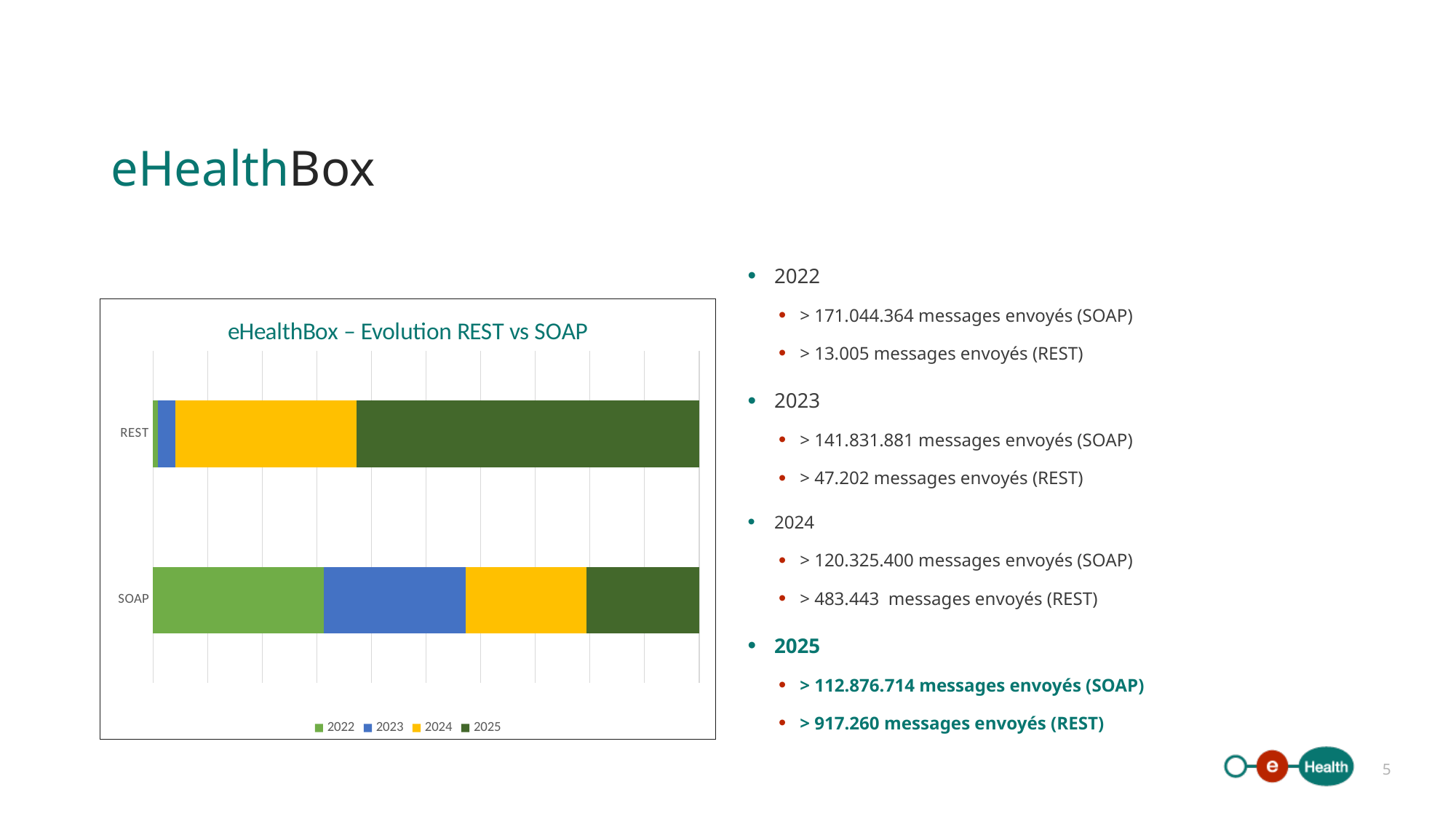
In the SOAP bar, which year's segment is the smallest? 2025 In the SOAP bar, which year's segment is the largest? 2022 Which years are listed in the chart legend? 2022, 2023, 2024, 2025 In the REST bar, which year's segment is the largest? 2025 What is the title of the chart? eHealthBox – Evolution REST vs SOAP In the REST bar, which year's segment is the smallest? 2022 In the SOAP bar, is the 2022 segment or the 2024 segment larger? 2022 How many categories are plotted on the chart's vertical axis? 2 In the REST bar, is the 2024 segment or the 2025 segment larger? 2025 How many series does the chart legend list? 4 Along the SOAP bar, do the segment sizes rise or fall from 2022 to 2025? Fall What kind of chart is shown on the slide? Stacked bar chart